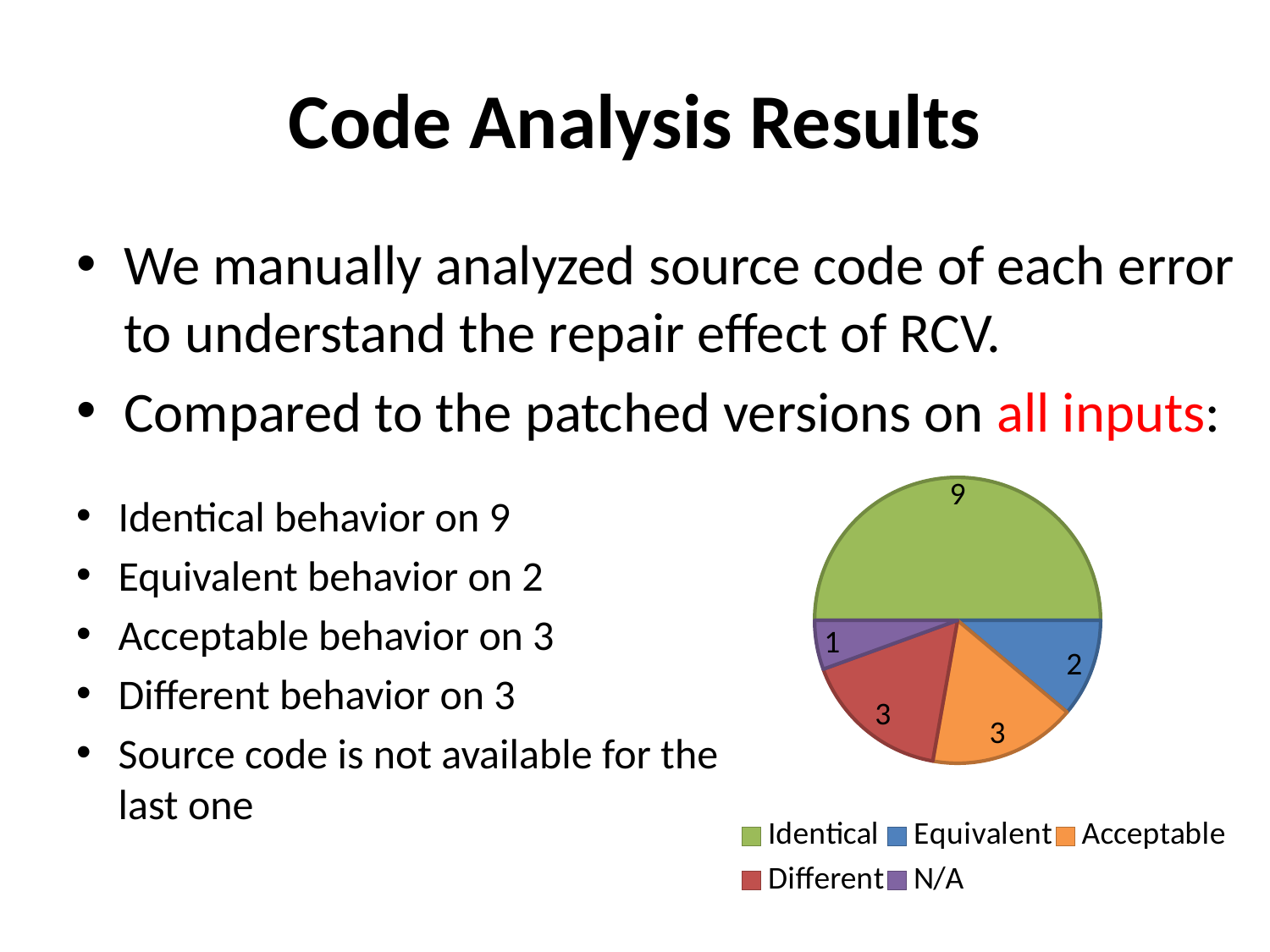
What is the difference between the Identical and Different values in the pie chart? 6 What share of the pie does the Identical slice represent? 50% What is the value of the Acceptable slice in the pie chart? 3 What is the value of the N/A slice in the pie chart? 1 What colour is the Different slice in the pie chart? red Which is larger in the pie chart, Identical or Equivalent? Identical Which category has the largest slice in the pie chart? Identical What is the value of the Equivalent slice in the pie chart? 2 What is the value of the Identical slice in the pie chart? 9 What type of chart is shown on the slide? pie chart How many slices does the pie chart have? 5 Which category has the smallest slice in the pie chart? N/A